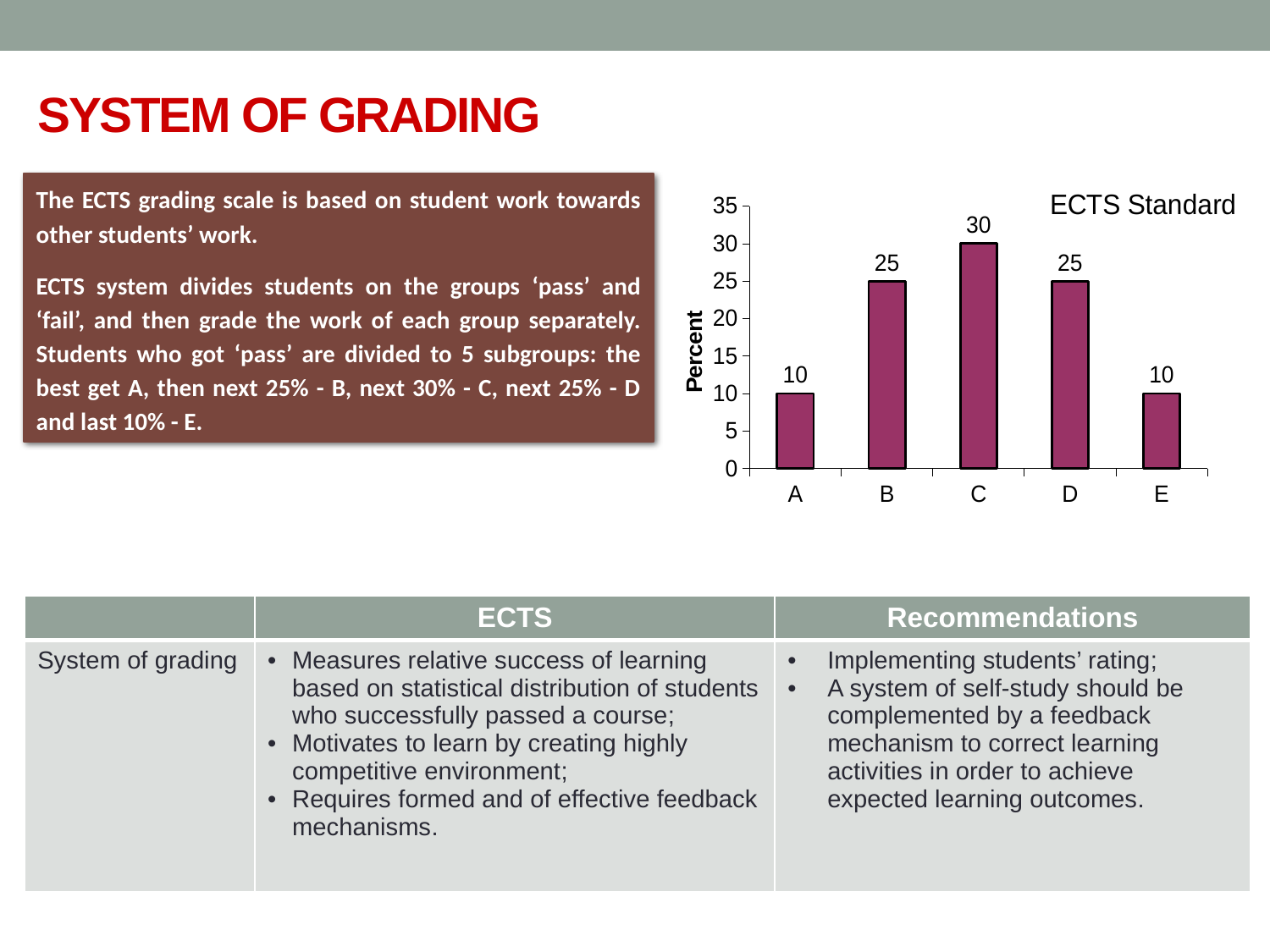
What kind of chart is the ECTS Standard chart? bar chart Which is larger in the ECTS Standard chart, the value for grade B or the value for grade E? B What is the title of the chart on the slide? ECTS Standard What is the value for grade B in the ECTS Standard chart? 25 Which grade has the highest value in the ECTS Standard chart? C Is the value for grade D in the ECTS Standard chart greater or less than 20? greater What is the difference between the values for grade B and grade A in the ECTS Standard chart? 15 What is the label of the vertical axis in the ECTS Standard chart? Percent How many grade categories are shown in the ECTS Standard chart? 5 What is the difference between the values for grade C and grade E in the ECTS Standard chart? 20 What is the value for grade C in the ECTS Standard chart? 30 What is the value for grade A in the ECTS Standard chart? 10